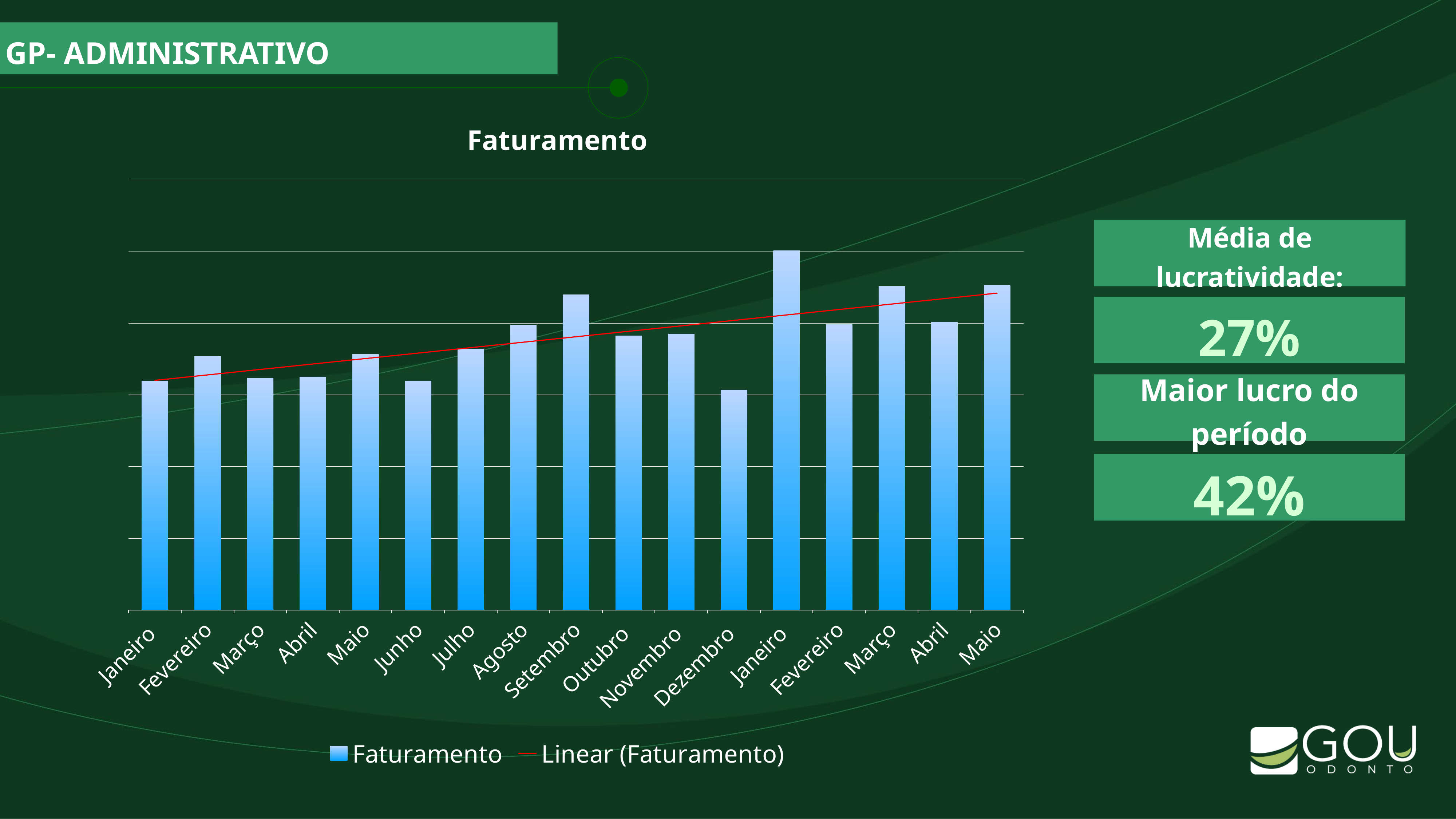
Which has the higher Faturamento bar, Setembro or Outubro? Setembro Does the red linear trendline for Faturamento rise or fall from left to right? rise How many series does the chart legend list? 2 Which month has the lowest Faturamento bar? Dezembro Which has the higher Faturamento bar, Junho or Julho? Julho Which month has the highest Faturamento bar? Janeiro (the second Janeiro, 13th bar) What is the title of the chart? Faturamento What kind of chart is shown on the slide? bar chart Which has the higher Faturamento bar, Novembro or Dezembro? Novembro How many bars (months) are plotted in the Faturamento chart? 17 What are the two entries listed in the chart legend? Faturamento and Linear (Faturamento)